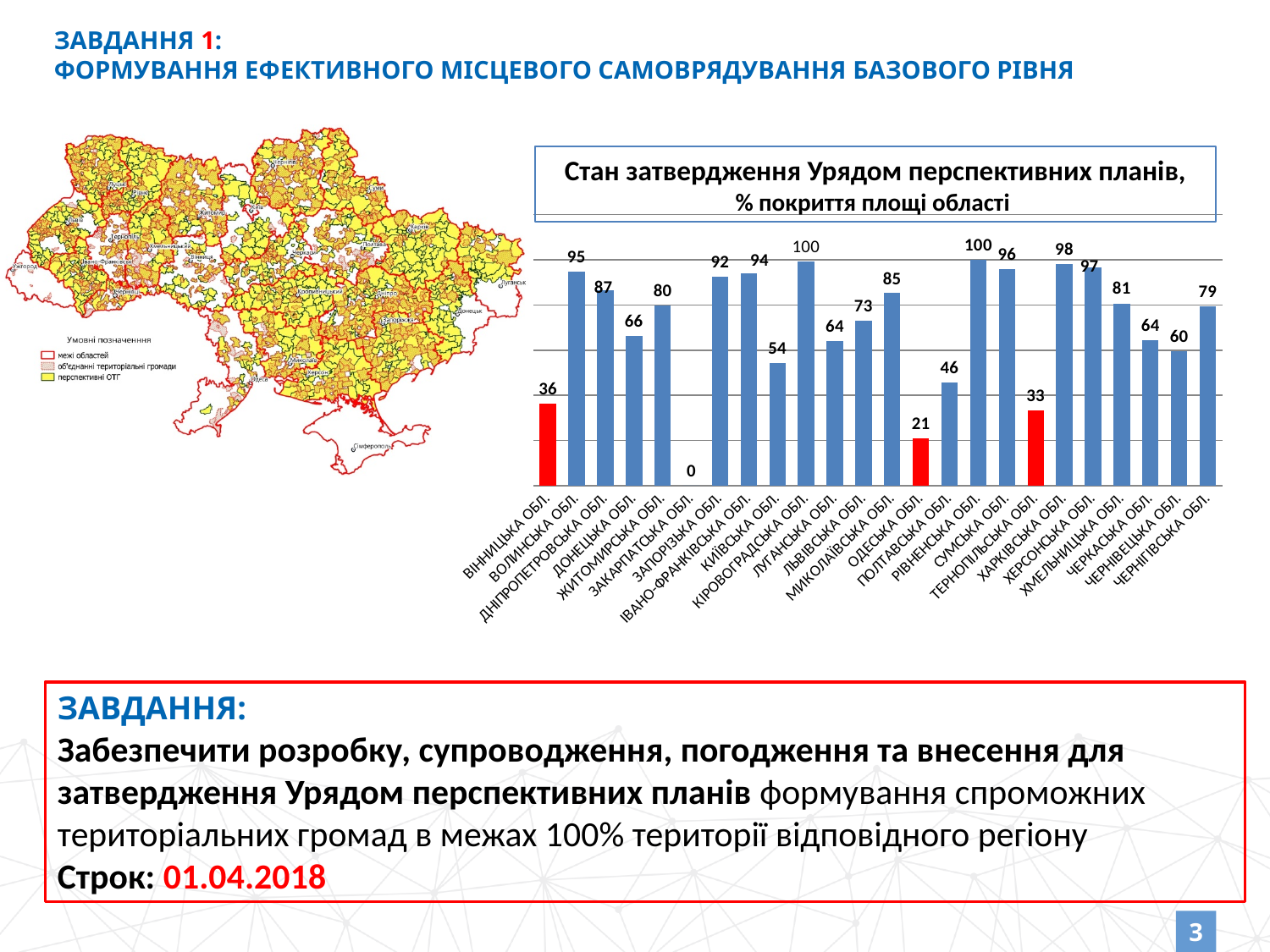
Which is larger, the value for Львівська обл. or the value for Миколаївська обл.? Миколаївська обл. What is the value for Одеська обл. in the bar chart? 21 How many regions are shown in the bar chart? 24 What is the difference between the values for Волинська обл. and Донецька обл.? 29 Which is larger, the value for Полтавська обл. or the value for Чернівецька обл.? Чернівецька обл. Which region has the lowest value in the bar chart? Закарпатська обл. What kind of chart is shown on the slide? Bar chart What is the difference between the values for Сумська обл. and Тернопільська обл.? 63 What is the value for Харківська обл. in the bar chart? 98 What is the value for Київська обл. in the bar chart? 54 What is the value for Вінницька обл. in the bar chart? 36 How many bars in the chart are coloured red? 3